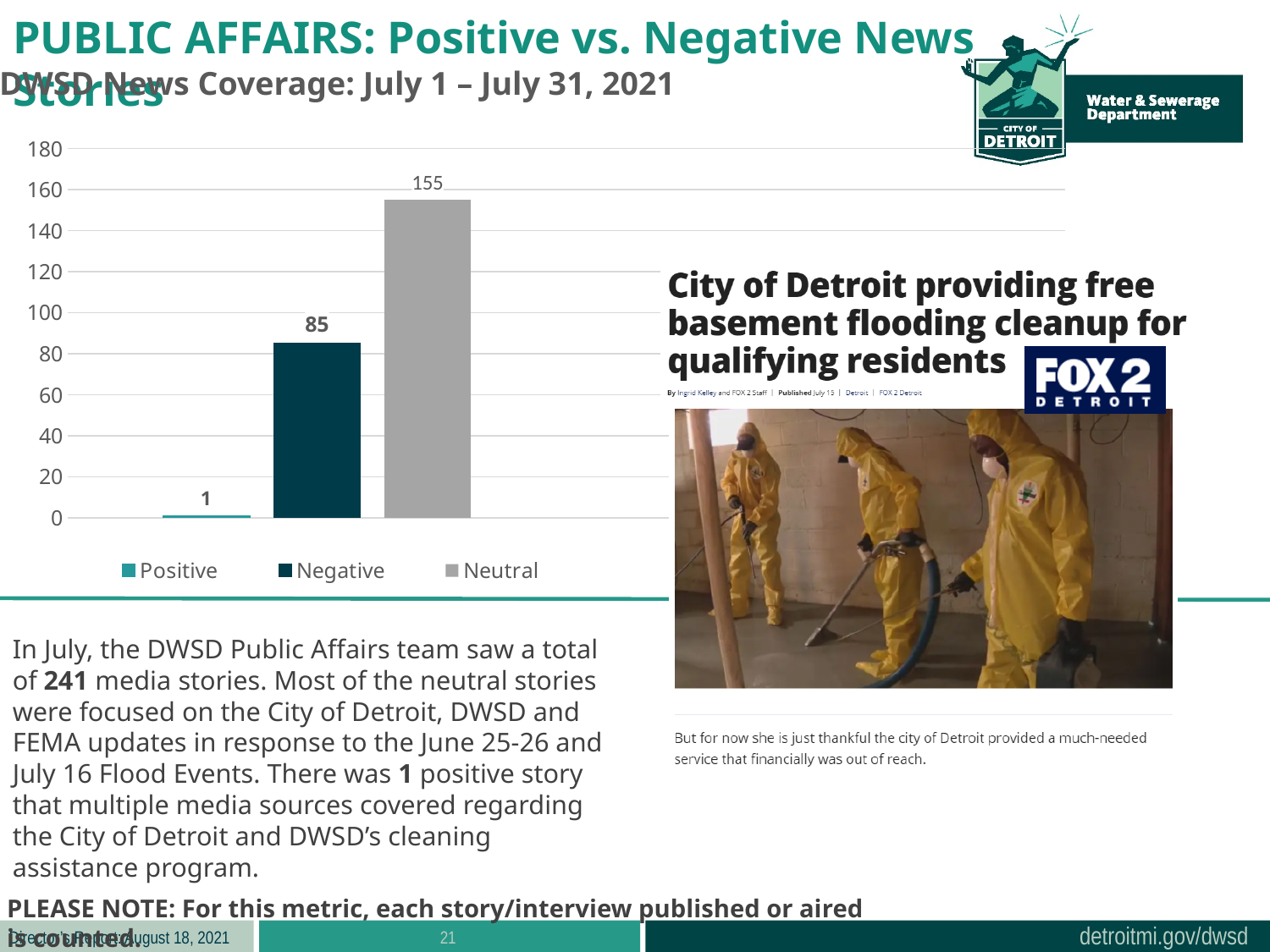
Which category has the lowest number of stories? Positive Which is larger, the Negative or the Neutral story count? Neutral How many categories are shown in the chart? 3 What is the title of the chart? DWSD News Coverage: July 1 – July 31, 2021 What is the difference between the Neutral and Negative story counts? 70 What kind of chart is shown on the slide? bar chart What is the value for Neutral news stories? 155 Is the value for Negative greater or less than 100? less What is the value for Negative news stories? 85 How many entries does the legend list? 3 What is the value for Positive news stories? 1 Which category has the highest number of stories? Neutral